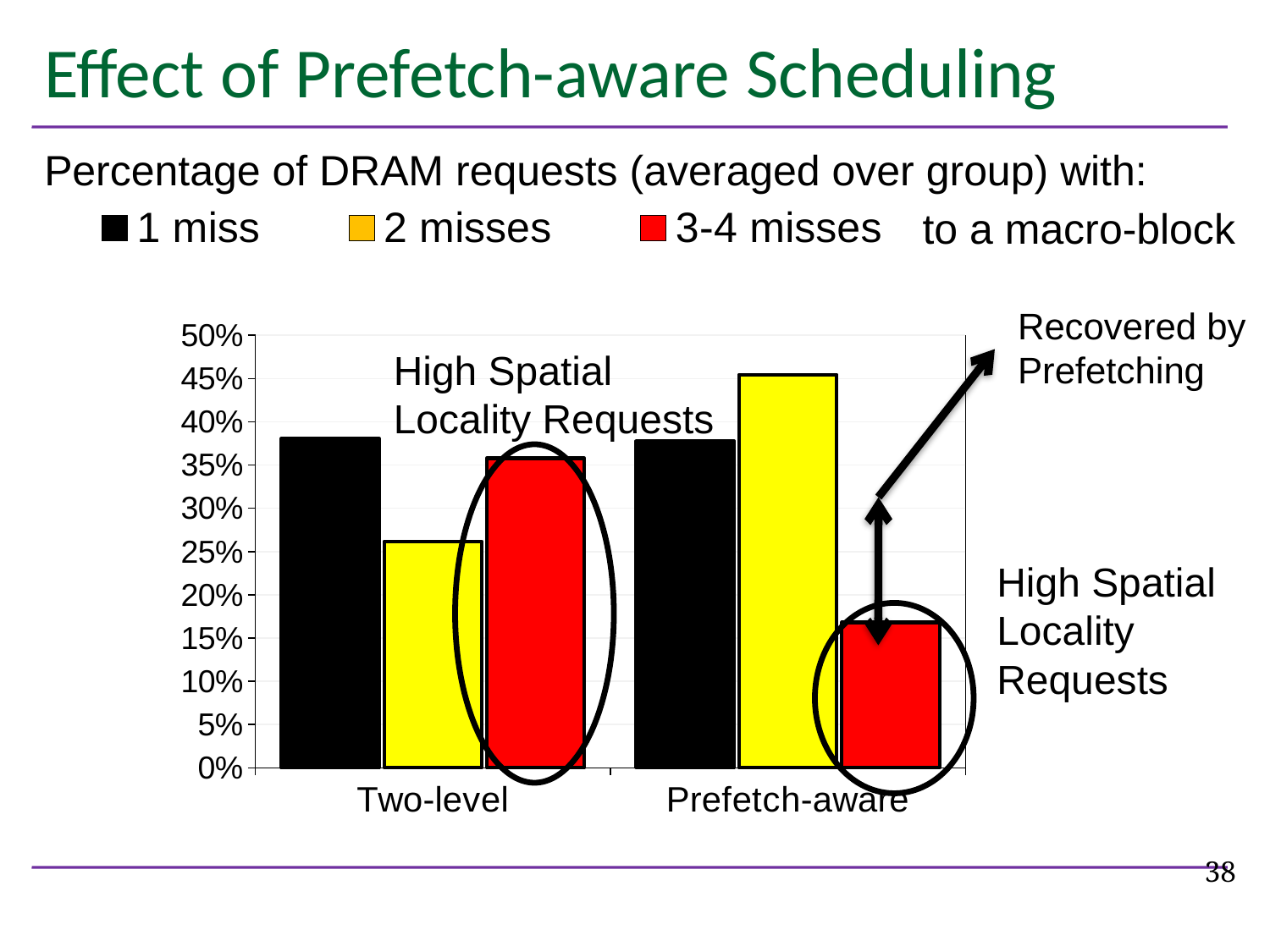
How many categories are shown on the x axis of the chart? 2 Is the value for 3-4 misses under Prefetch-aware greater or less than 20%? less For 3-4 misses, which category has the larger value: Two-level or Prefetch-aware? Two-level Which is larger for Two-level: 2 misses or 3-4 misses? 3-4 misses How many series does the legend list? 3 Which series has the highest value for Prefetch-aware? 2 misses What kind of chart is shown on the slide? bar chart Is the value for 2 misses under Prefetch-aware greater or less than 40%? greater What colour represents the 3-4 misses series in the chart? red Is the value for 2 misses under Two-level greater or less than 30%? less Which series has the lowest value for Prefetch-aware? 3-4 misses Which series has the lowest value for Two-level? 2 misses